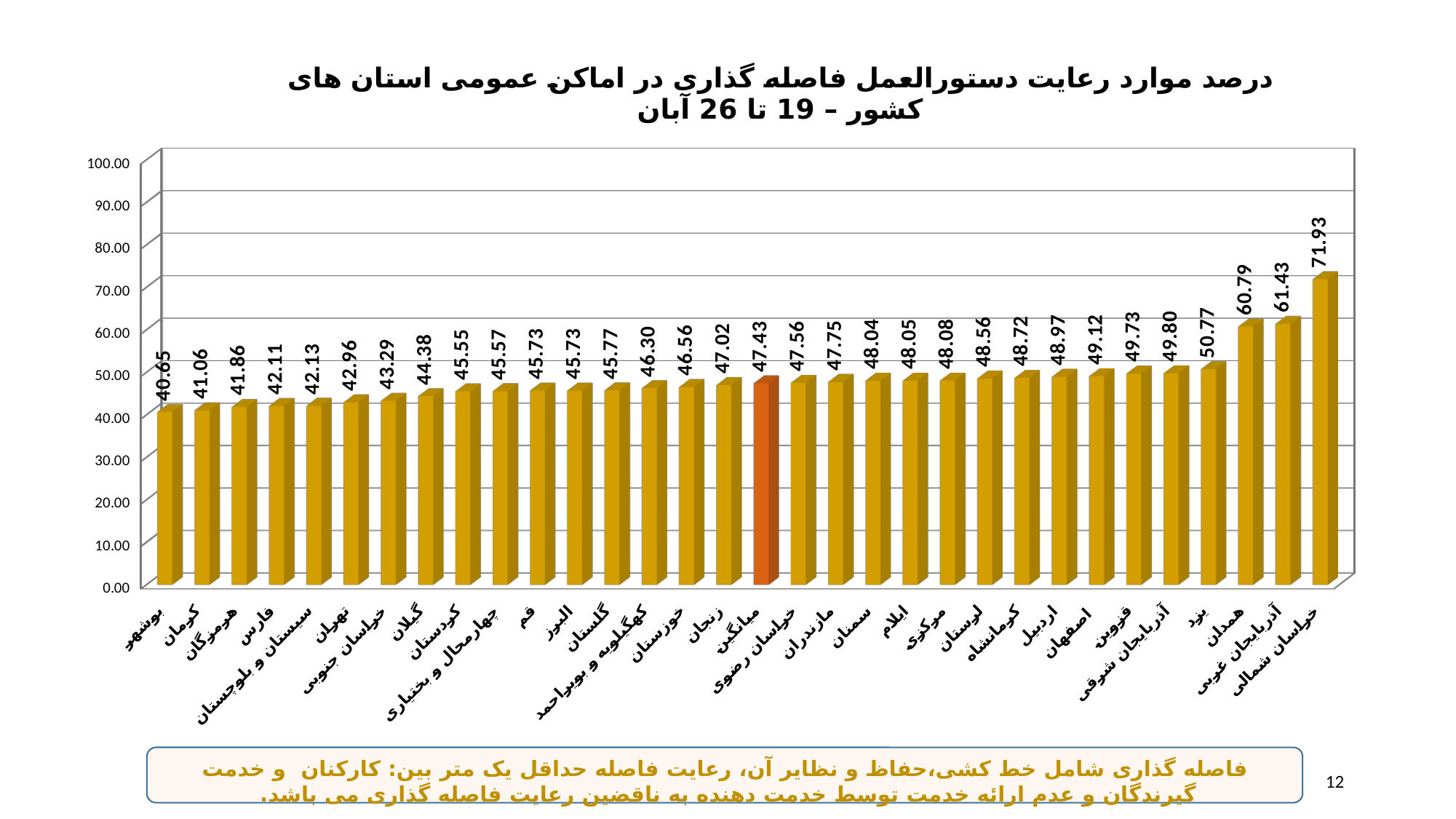
How many bars are plotted in the chart? 32 What is the difference between the values for آذربایجان غربی and همدان? 0.64 Which has a larger value, یزد or گیلان? یزد What kind of chart is shown on the slide? bar chart What is the value shown for the میانگین (average) bar? 47.43 Which category has the highest value? خراسان شمالی Which bar is shown in a different colour (orange) from the others? میانگین Is the value for خراسان شمالی greater or less than 70.00? greater Which category has the lowest value? بوشهر What is the value shown for تهران? 42.96 What is the value shown for همدان? 60.79 What is the difference between the values for خراسان شمالی and بوشهر? 31.28